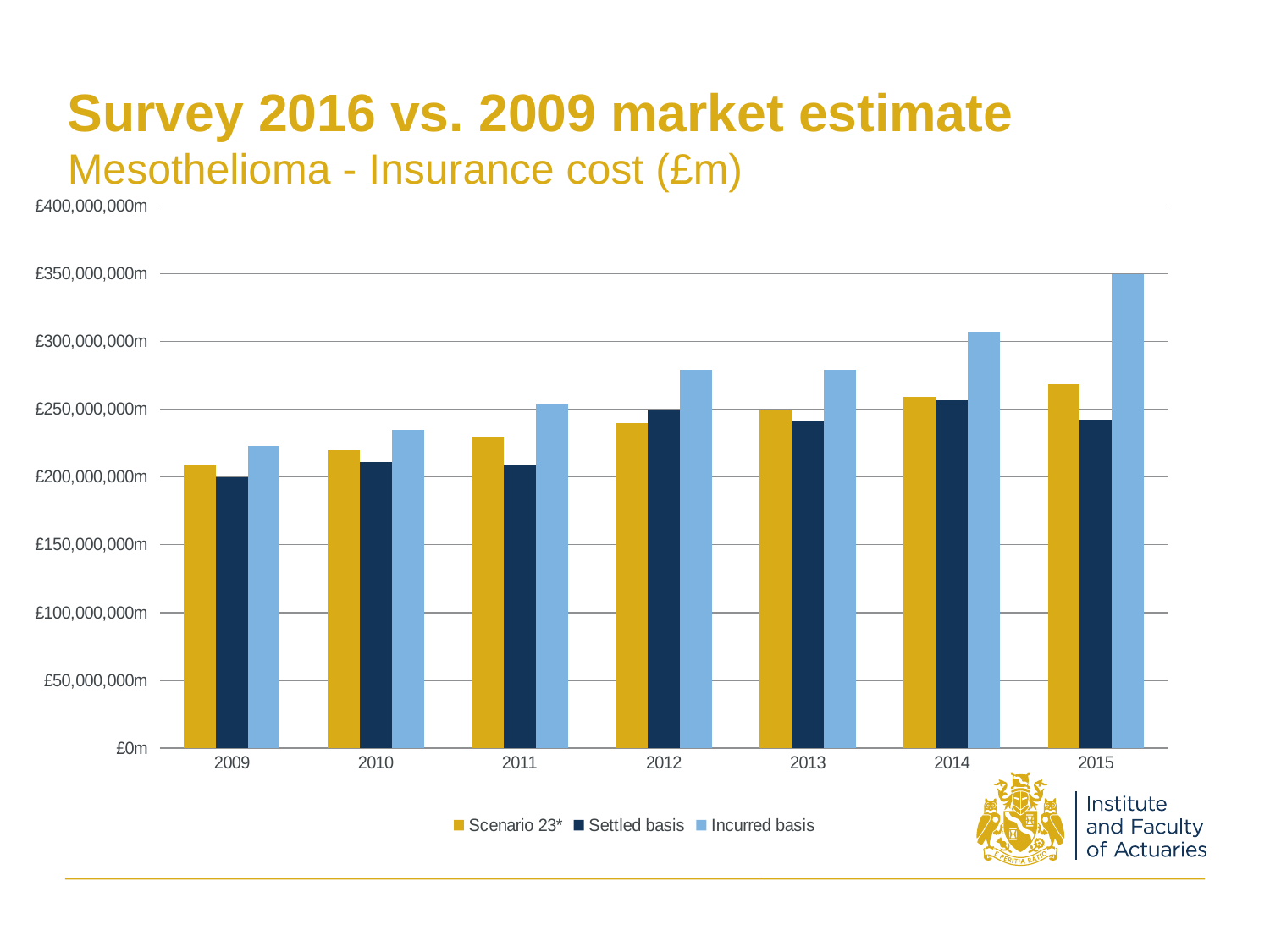
Which year has the lowest Incurred basis value? 2009 What are the three series named in the legend? Scenario 23*, Settled basis, Incurred basis How many series does the legend list? 3 In 2015, which is larger: the Incurred basis value or the Settled basis value? Incurred basis In 2012, which is larger: the Settled basis value or the Scenario 23* value? Settled basis Is the Scenario 23* value for 2015 greater or less than £250,000,000m? greater Which year has the highest Incurred basis value? 2015 What kind of chart is shown on the slide? Bar chart Do the Incurred basis values rise or fall from 2009 to 2015? rise Which year has the highest Scenario 23* value? 2015 Is the Incurred basis value for 2012 greater or less than £300,000,000m? less How many years are shown on the x axis? 7